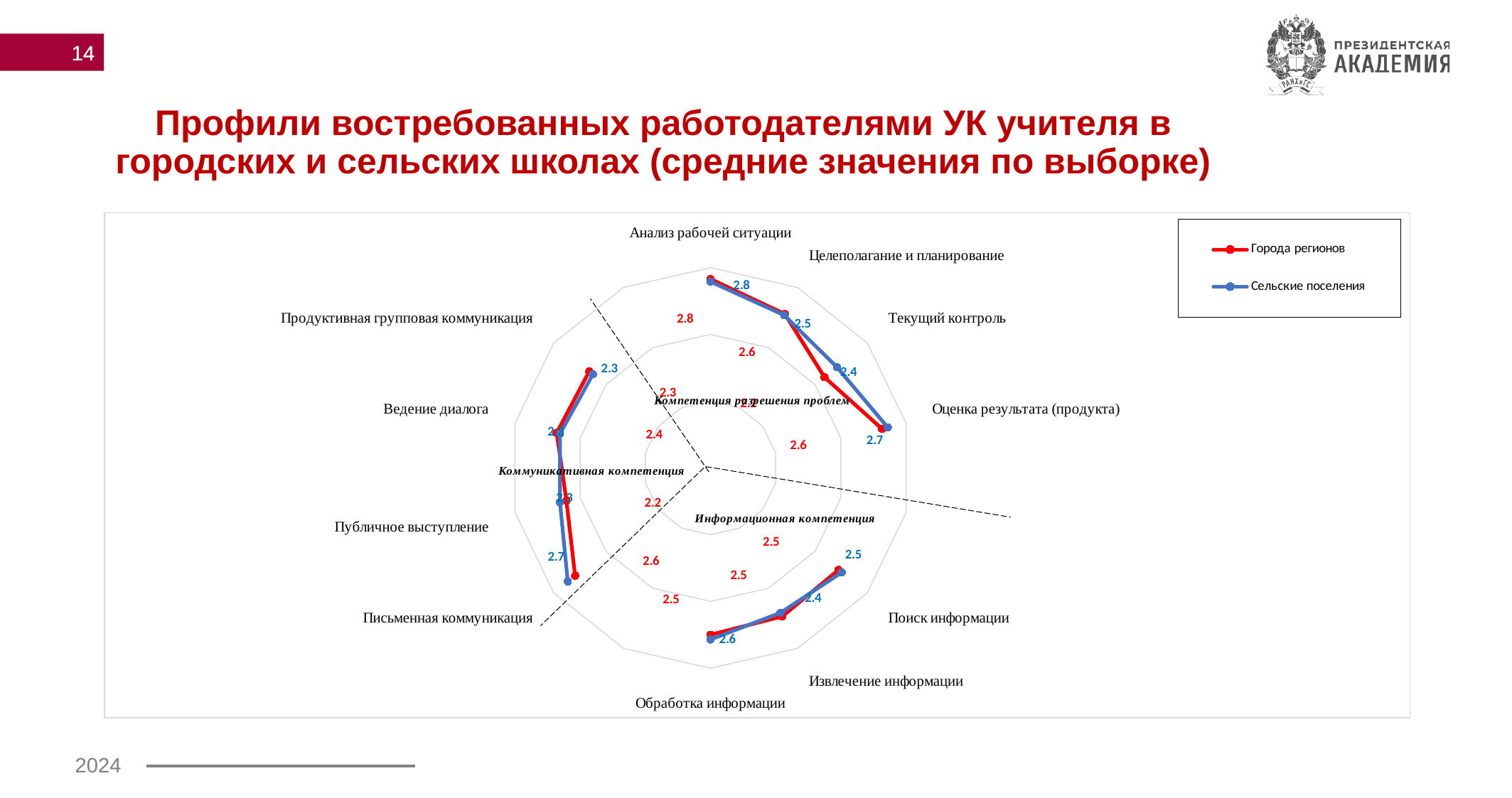
How many series does the legend list? 2 What is the value for Сельские поселения on the axis Анализ рабочей ситуации? 2.8 Which colour represents the series Города регионов in the legend? Red What is the difference between the Сельские поселения values for Анализ рабочей ситуации and Текущий контроль? 0.4 What is the value for Сельские поселения on the axis Текущий контроль? 2.4 On the axis Текущий контроль, which series has the larger value: Города регионов or Сельские поселения? Сельские поселения What kind of chart is shown on the slide? Radar chart What is the value for Сельские поселения on the axis Продуктивная групповая коммуникация? 2.3 On which axis does the Сельские поселения series reach its highest value? Анализ рабочей ситуации What is the value for Сельские поселения on the axis Оценка результата (продукта)? 2.7 What is the value for Сельские поселения on the axis Обработка информации? 2.6